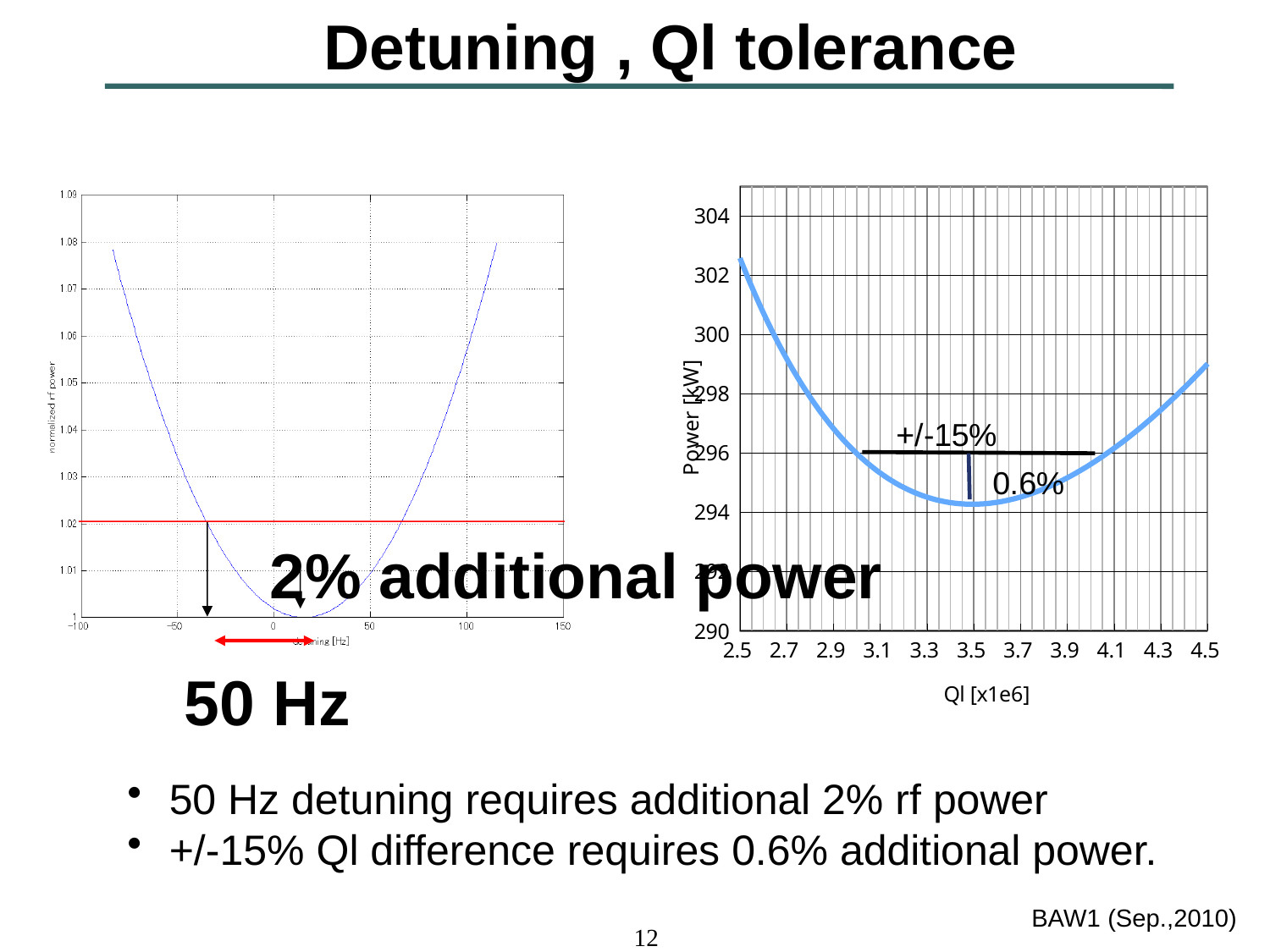
In the right-hand chart, is the power at Ql = 3.5 greater or less than 296 kW? less What is the x-axis label of the right-hand chart? Ql [x1e6] What kind of chart is the left-hand chart (normalized rf power vs detuning)? line chart In the left-hand chart, is the normalized rf power at a detuning of 100 Hz greater or less than 1.04? greater In the left-hand chart, which detuning gives the higher normalized rf power: -50 Hz or 50 Hz? -50 Hz In the right-hand chart, how does the power change as Ql increases from 2.5 to 4.5? It falls to a minimum near 3.5, then rises In the right-hand chart, which has the higher power: Ql = 2.5 or Ql = 4.5? Ql = 2.5 In the right-hand chart, is the power at Ql = 4.5 greater or less than 300 kW? less What kind of chart is the right-hand chart (Power [kW] vs Ql)? line chart